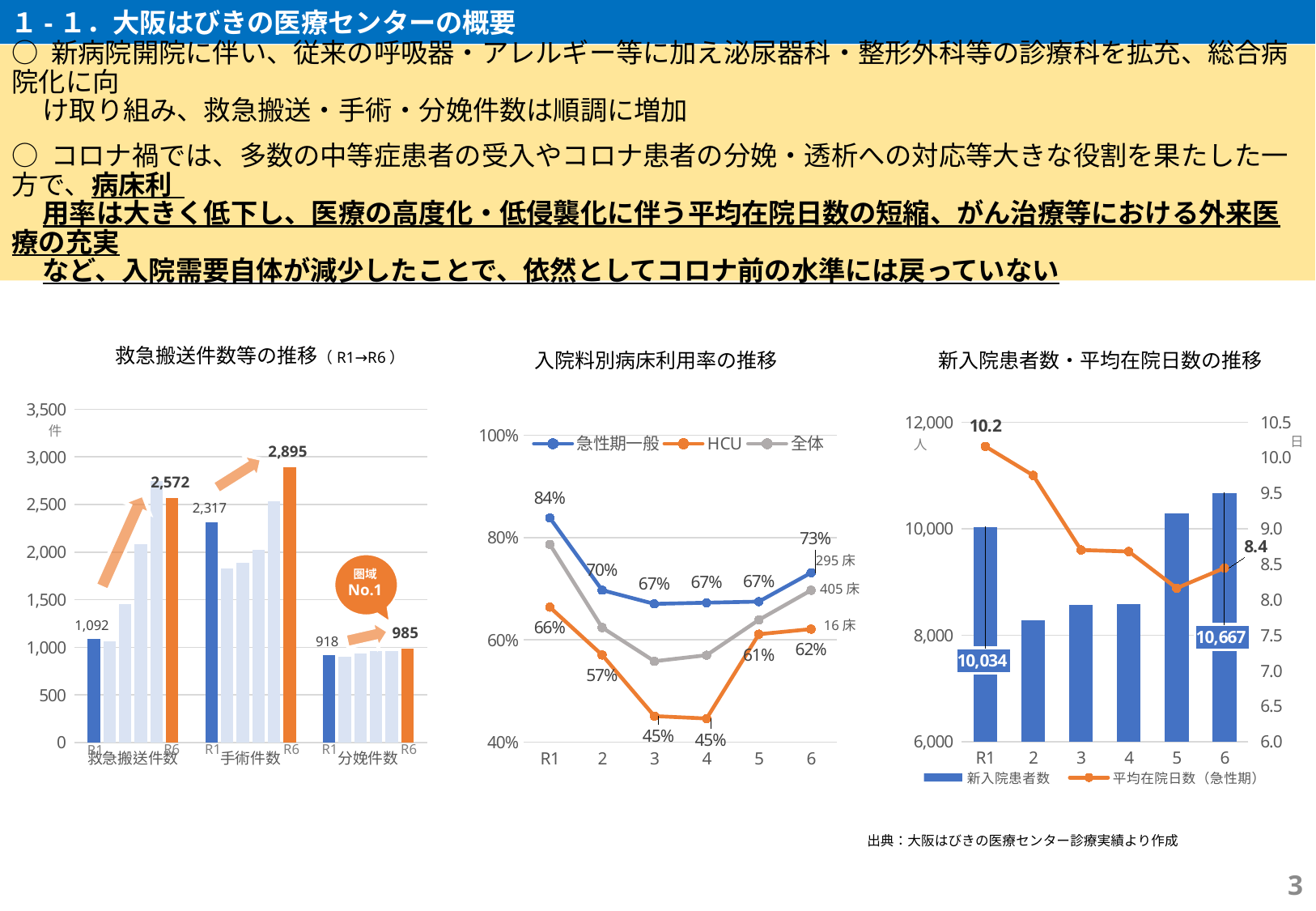
In the chart titled 救急搬送件数等の推移, what is the R1 value for 手術件数? 2,317 In the chart titled 救急搬送件数等の推移, what is the difference between the R6 and R1 values for 救急搬送件数? 1,480 In the chart titled 入院料別病床利用率の推移, what is the value of HCU at R1? 66% In the chart titled 入院料別病床利用率の推移, how many series does the legend list? 3 In the chart titled 救急搬送件数等の推移, what is the R6 value for 救急搬送件数? 2,572 In the chart titled 入院料別病床利用率の推移, what kind of chart is it? Line chart In the chart titled 新入院患者数・平均在院日数の推移, what is the 新入院患者数 value at R1? 10,034 In the chart titled 新入院患者数・平均在院日数の推移, what is the 平均在院日数 value at year 6? 8.4 In the chart titled 救急搬送件数等の推移, which of the three categories has the highest R6 value? 手術件数 In the chart titled 入院料別病床利用率の推移, what is the lowest value shown for HCU? 45% In the chart titled 入院料別病床利用率の推移, what is the value of 急性期一般 at year 6? 73% In the chart titled 救急搬送件数等の推移, by how much did 分娩件数 increase from R1 to R6? 67